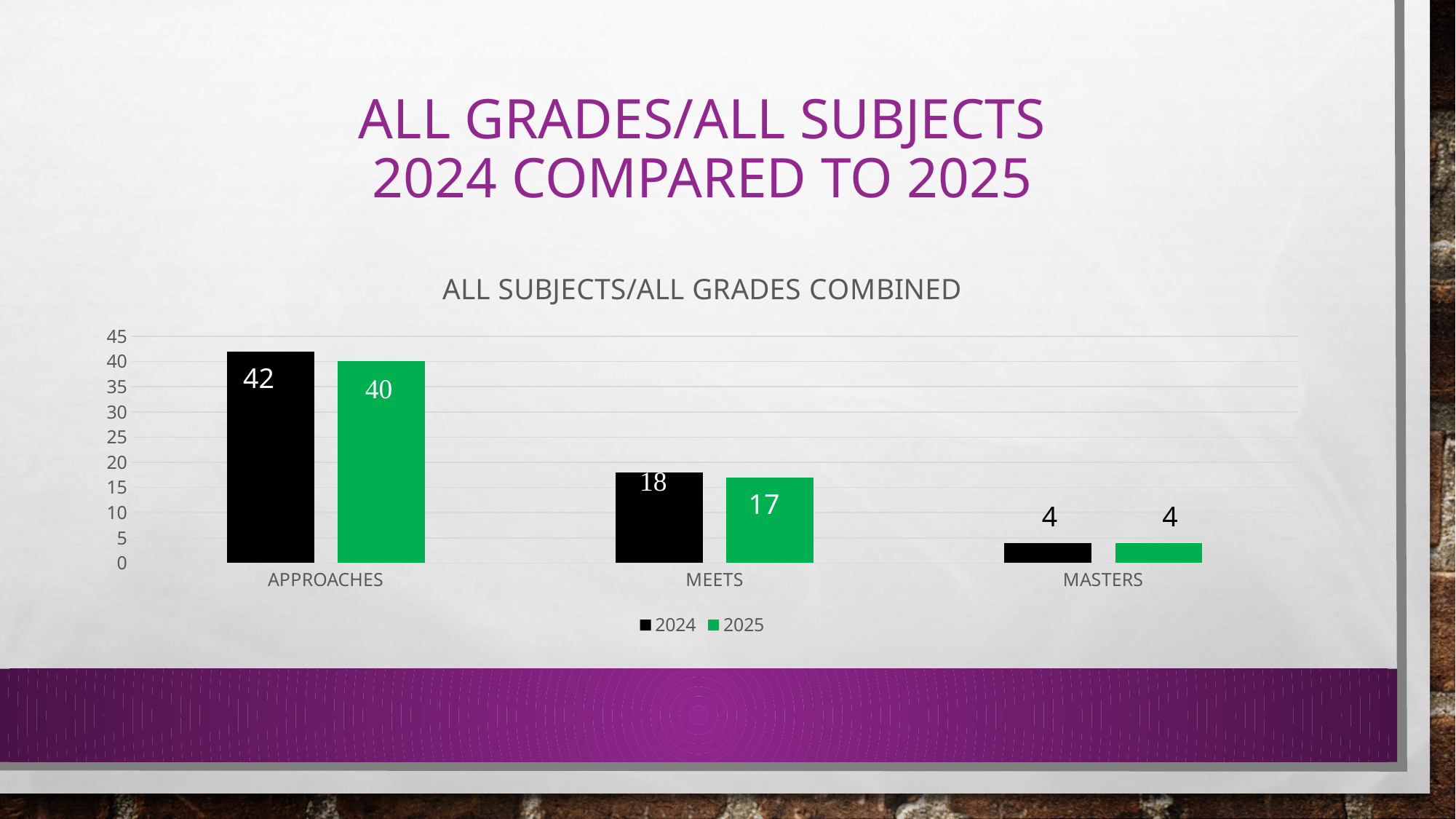
What is the difference between the 2024 values for Approaches and Meets? 24 What is the 2024 value for Approaches? 42 What is the title of the chart? All Subjects/All Grades Combined Which category has the lowest 2025 value? Masters How many series does the legend list? 2 What is the difference between the 2024 and 2025 values for Approaches? 2 What is the 2025 value for Masters? 4 Which is larger, the 2024 value for Meets or the 2025 value for Meets? 2024 What is the 2025 value for Meets? 17 What kind of chart is shown on the slide? Bar chart How many categories are shown on the x axis? 3 Which category has the highest 2024 value? Approaches